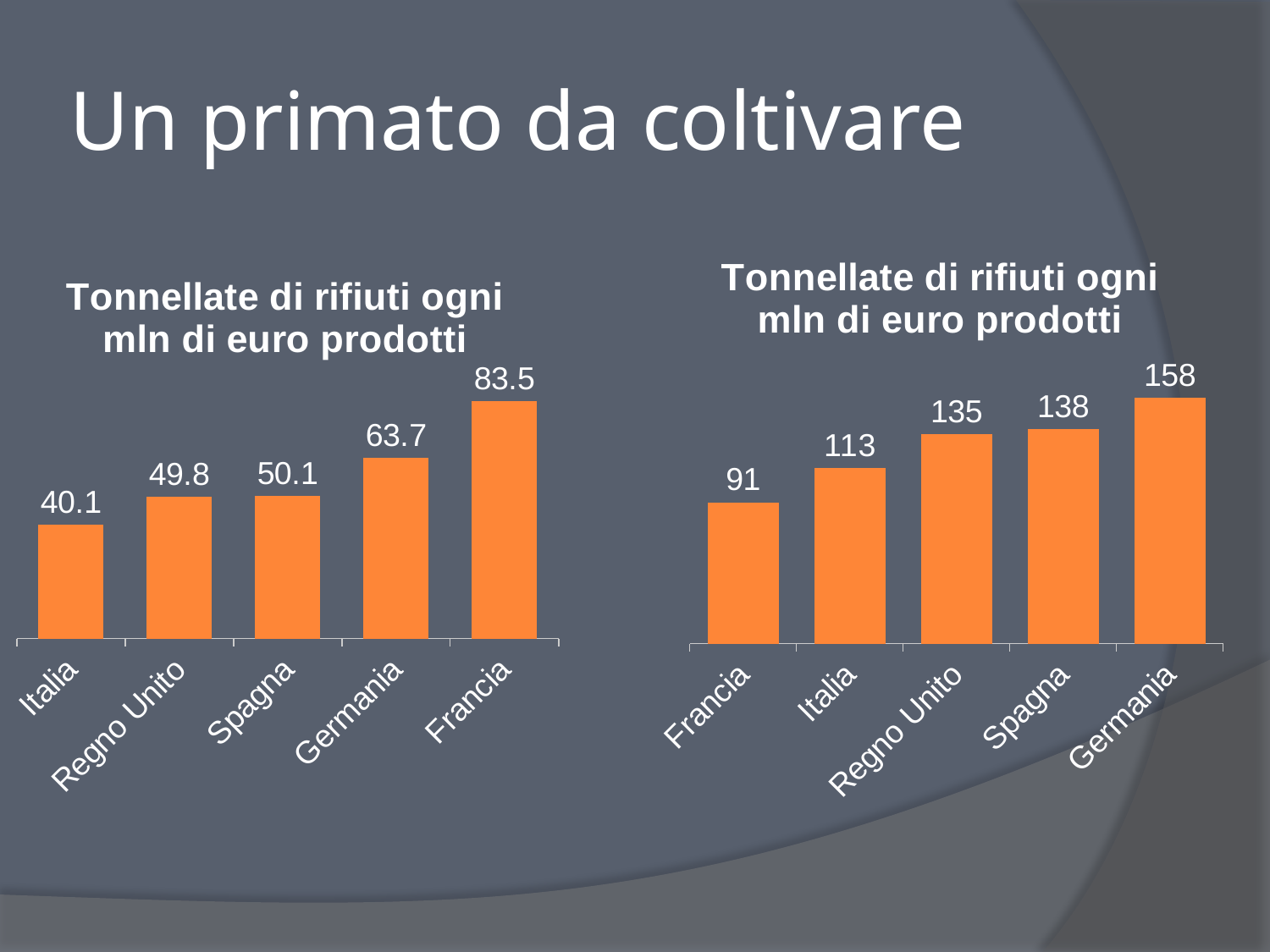
In the right chart, which country has the highest value? Germania In the right chart, do the values rise or fall from left to right? rise In the right chart, what is the difference between the values for Germania and Francia? 67 In the left chart, how many countries are shown? 5 In the left chart, what is the value for Germania? 63.7 In the left chart, which country has the highest value? Francia What kind of chart is the right chart? bar chart In the left chart, what is the value for Italia? 40.1 In the left chart, what is the difference between the values for Francia and Italia? 43.4 In the left chart, which country has the lowest value? Italia In the right chart, what is the value for Regno Unito? 135 In the right chart, what is the value for Francia? 91